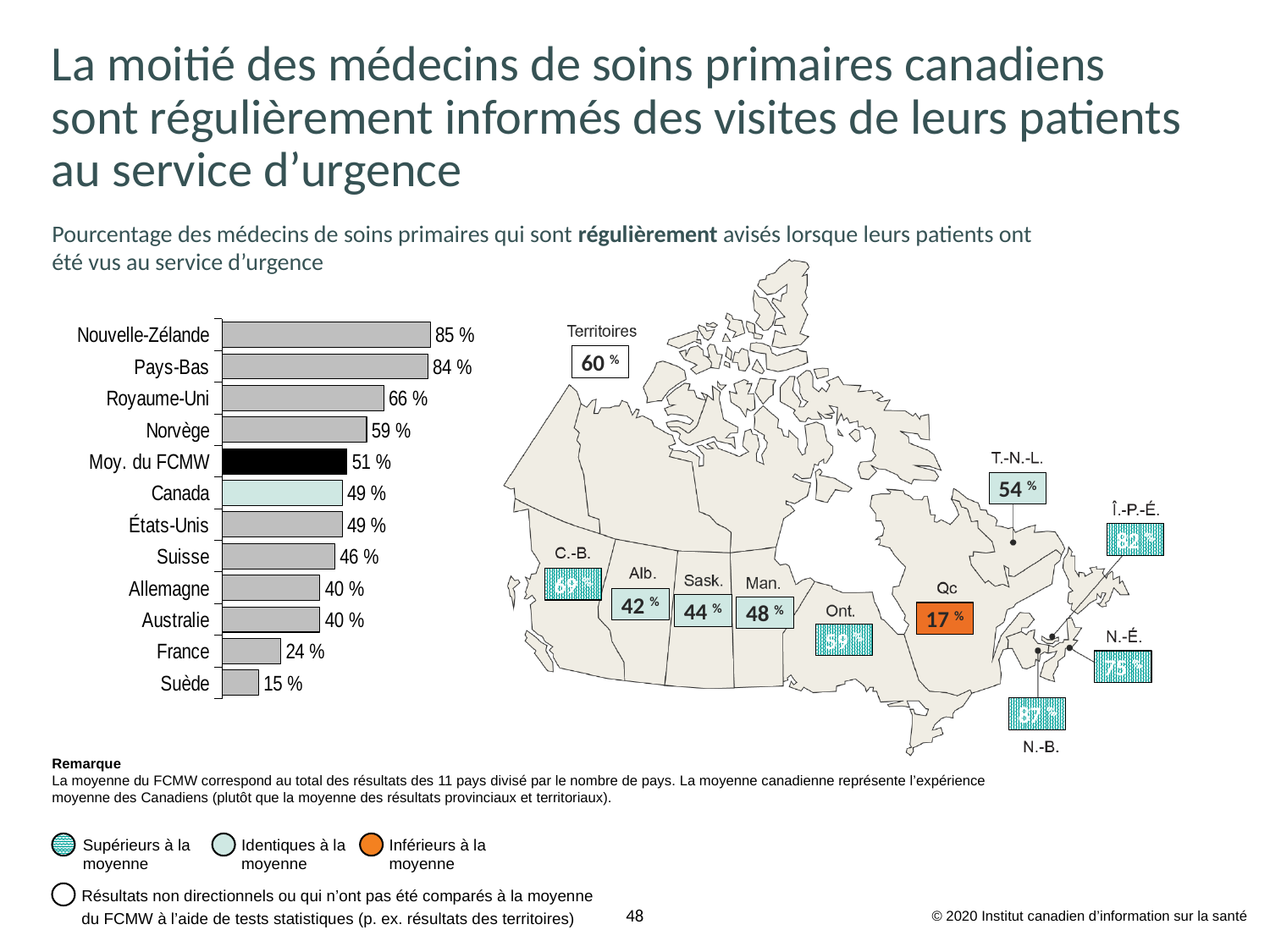
In the bar chart, what is the value for Nouvelle-Zélande? 85 % In the bar chart, which is larger, the value for Norvège or the value for Suisse? Norvège In the bar chart, what is the value for Canada? 49 % In the bar chart, what is the value for Moy. du FCMW? 51 % What kind of chart is shown on the left of the slide? Bar chart How many categories are shown in the bar chart? 12 On the map of Canada, what is the value shown for Qc? 17 % In the bar chart, which category has the highest value? Nouvelle-Zélande In the bar chart, what is the difference between the values for Royaume-Uni and France? 42 % In the bar chart, which country has the lowest value? Suède On the map of Canada, which is larger, the value for Alb. or the value for Man.? Man. On the map of Canada, what is the value shown for N.-B.? 87 %